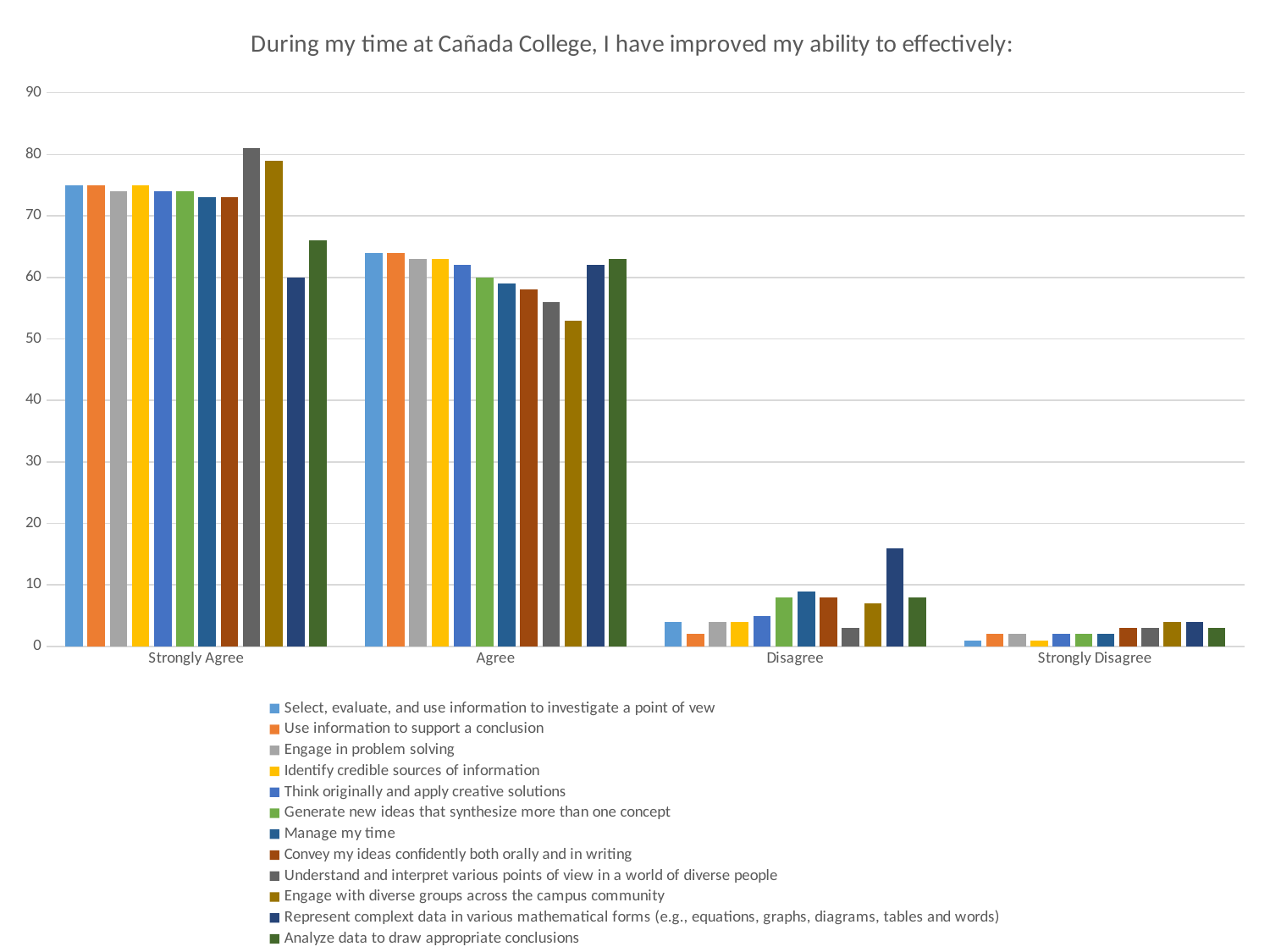
In the Disagree category, which series has the highest bar? Represent complext data in various mathematical forms (e.g., equations, graphs, diagrams, tables and words) In the Agree category, which series has the lowest bar? Engage with diverse groups across the campus community In the Strongly Agree category, which is larger: 'Engage with diverse groups across the campus community' or 'Analyze data to draw appropriate conclusions'? Engage with diverse groups across the campus community In the Strongly Agree category, which series has the highest bar? Understand and interpret various points of view in a world of diverse people In the Strongly Agree category, which series has the lowest bar? Represent complext data in various mathematical forms (e.g., equations, graphs, diagrams, tables and words) What is the title of the chart? During my time at Cañada College, I have improved my ability to effectively: What kind of chart is shown on the slide? bar chart Is the Disagree value for 'Represent complext data in various mathematical forms' greater or less than 10? greater How many series does the legend list? 12 For the series 'Manage my time', do the values rise or fall moving from Strongly Agree to Strongly Disagree? fall How many response categories are shown along the x axis? 4